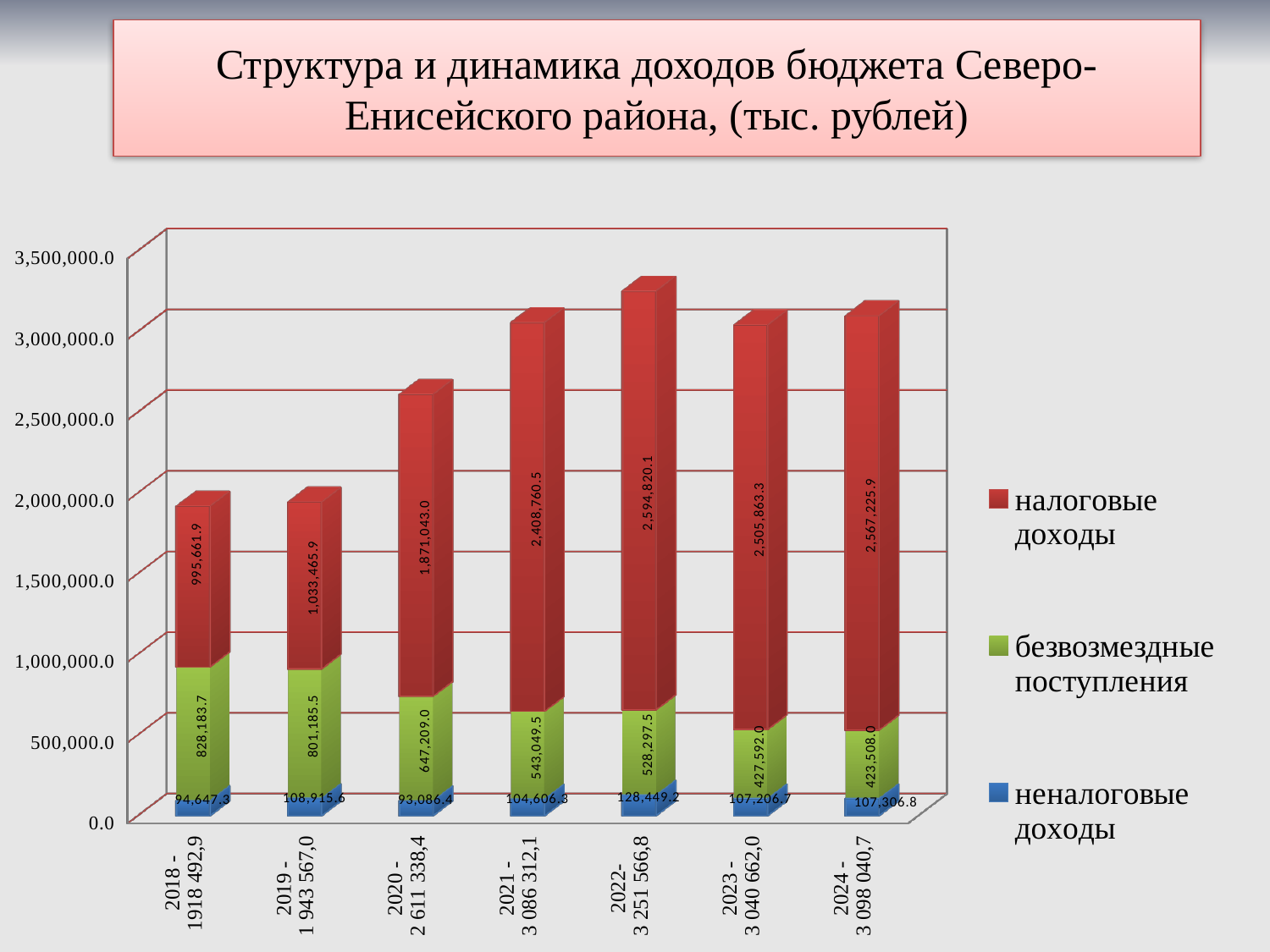
How many years are shown on the x axis? 7 What is the difference between налоговые доходы in 2020 and in 2019? 837,577.1 What is the value of безвозмездные поступления for 2018? 828,183.7 What is the value of неналоговые доходы for 2022? 128,449.2 Which year has the lowest value of безвозмездные поступления? 2024 Which year has the highest value of налоговые доходы? 2022 What kind of chart is shown on the slide? Stacked bar chart What is the total of the stacked bar for 2022? 3 251 566,8 Which year has the larger value of неналоговые доходы, 2019 or 2021? 2019 Do the values of безвозмездные поступления rise or fall from 2018 to 2024? Fall What is the value of налоговые доходы for 2021? 2,408,760.5 How many series does the legend list? 3